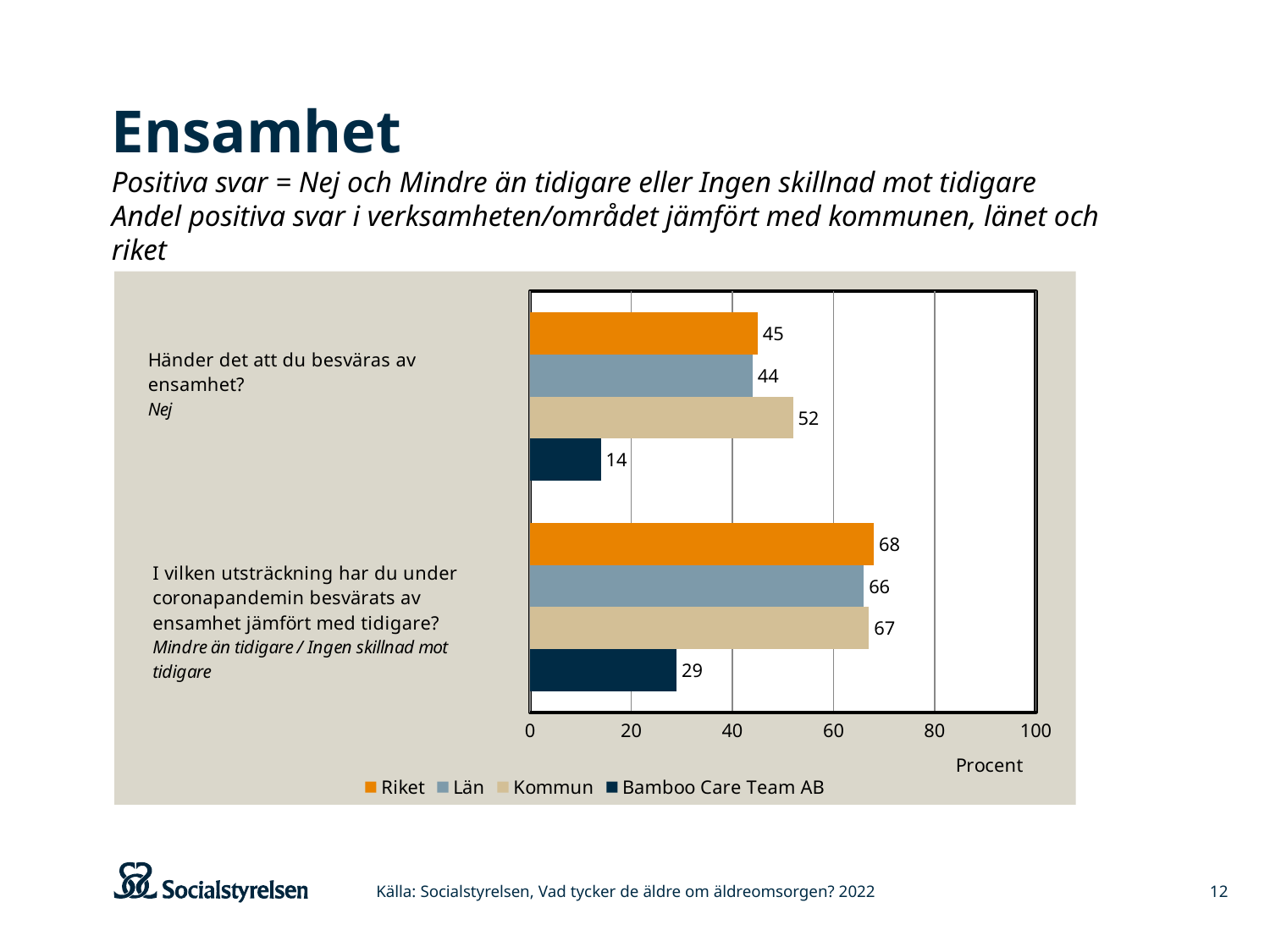
Which series has the highest value for the question 'Händer det att du besväras av ensamhet?' Kommun What value is shown for Riket for the question 'Händer det att du besväras av ensamhet?' 45 What is the difference between the Riket and Bamboo Care Team AB values for the question 'I vilken utsträckning har du under coronapandemin besvärats av ensamhet jämfört med tidigare?' 39 Which series has the lowest value for the question 'I vilken utsträckning har du under coronapandemin besvärats av ensamhet jämfört med tidigare?' Bamboo Care Team AB How many series does the legend list? 4 What value is shown for Bamboo Care Team AB for the question 'Händer det att du besväras av ensamhet?' 14 What value is shown for Kommun for the question 'I vilken utsträckning har du under coronapandemin besvärats av ensamhet jämfört med tidigare?' 67 What is the difference between the Kommun and Bamboo Care Team AB values for the question 'Händer det att du besväras av ensamhet?' 38 Which is larger for the question 'Händer det att du besväras av ensamhet?': the value for Riket or the value for Kommun? Kommun What is the label of the x axis? Procent What value is shown for Län for the question 'I vilken utsträckning har du under coronapandemin besvärats av ensamhet jämfört med tidigare?' 66 What kind of chart is shown on the slide? Bar chart